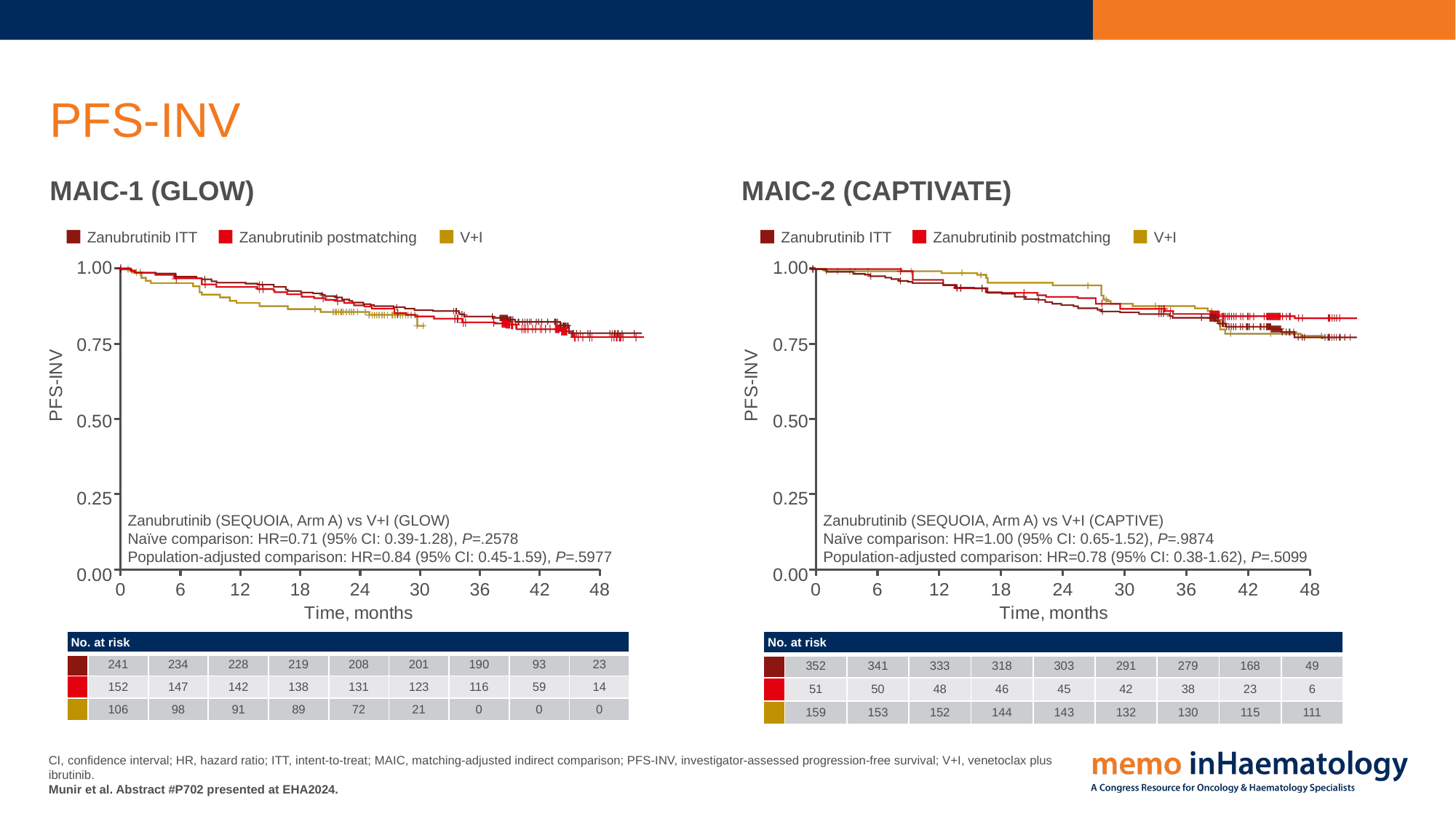
In the MAIC-2 (CAPTIVATE) chart, which series has the largest number at risk at 48 months? V+I In the MAIC-1 (GLOW) chart, what is the number at risk for V+I at 30 months? 21 What kind of chart is the MAIC-2 (CAPTIVATE) chart? Line chart (Kaplan-Meier curves) What is the x-axis label of the MAIC-2 (CAPTIVATE) chart? Time, months In the MAIC-2 (CAPTIVATE) chart, what is the hazard ratio for the population-adjusted comparison? HR=0.78 In the MAIC-1 (GLOW) chart, what is the number at risk for Zanubrutinib ITT at month 0? 241 In the MAIC-2 (CAPTIVATE) chart, by how much does the number at risk for Zanubrutinib ITT decrease from month 0 to month 48? 303 In the MAIC-1 (GLOW) chart, how many series does the legend list? 3 In the MAIC-1 (GLOW) chart, do the PFS-INV curves rise or fall over time? Fall In the MAIC-2 (CAPTIVATE) chart, what is the number at risk for Zanubrutinib postmatching at 48 months? 6 In the MAIC-1 (GLOW) chart, is the V+I curve at 24 months greater or less than 0.75? greater In the MAIC-1 (GLOW) chart, what is the hazard ratio for the naïve comparison? HR=0.71